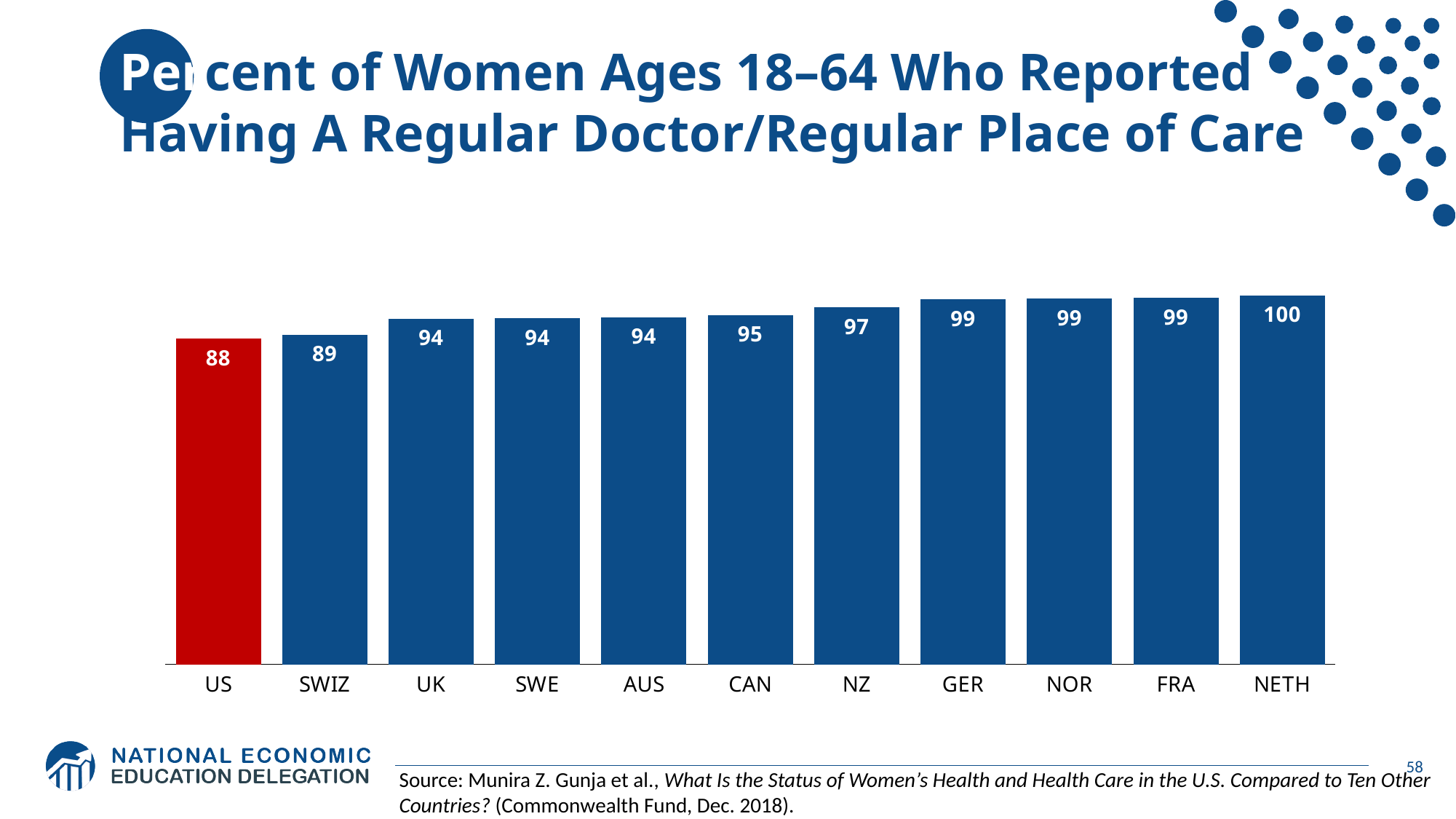
Which bar is coloured red rather than blue? US Which has a larger value, UK or NZ? NZ What is the value for NZ? 97 How many countries are shown in the chart? 11 Do the values rise or fall from left to right across the chart? Rise What kind of chart is shown on the slide? Bar chart Which country has the lowest value? US What is the difference between the values for NETH and the US? 12 What is the value for CAN? 95 What is the value for the US? 88 What is the difference between the values for SWIZ and the US? 1 Which country has the highest value? NETH